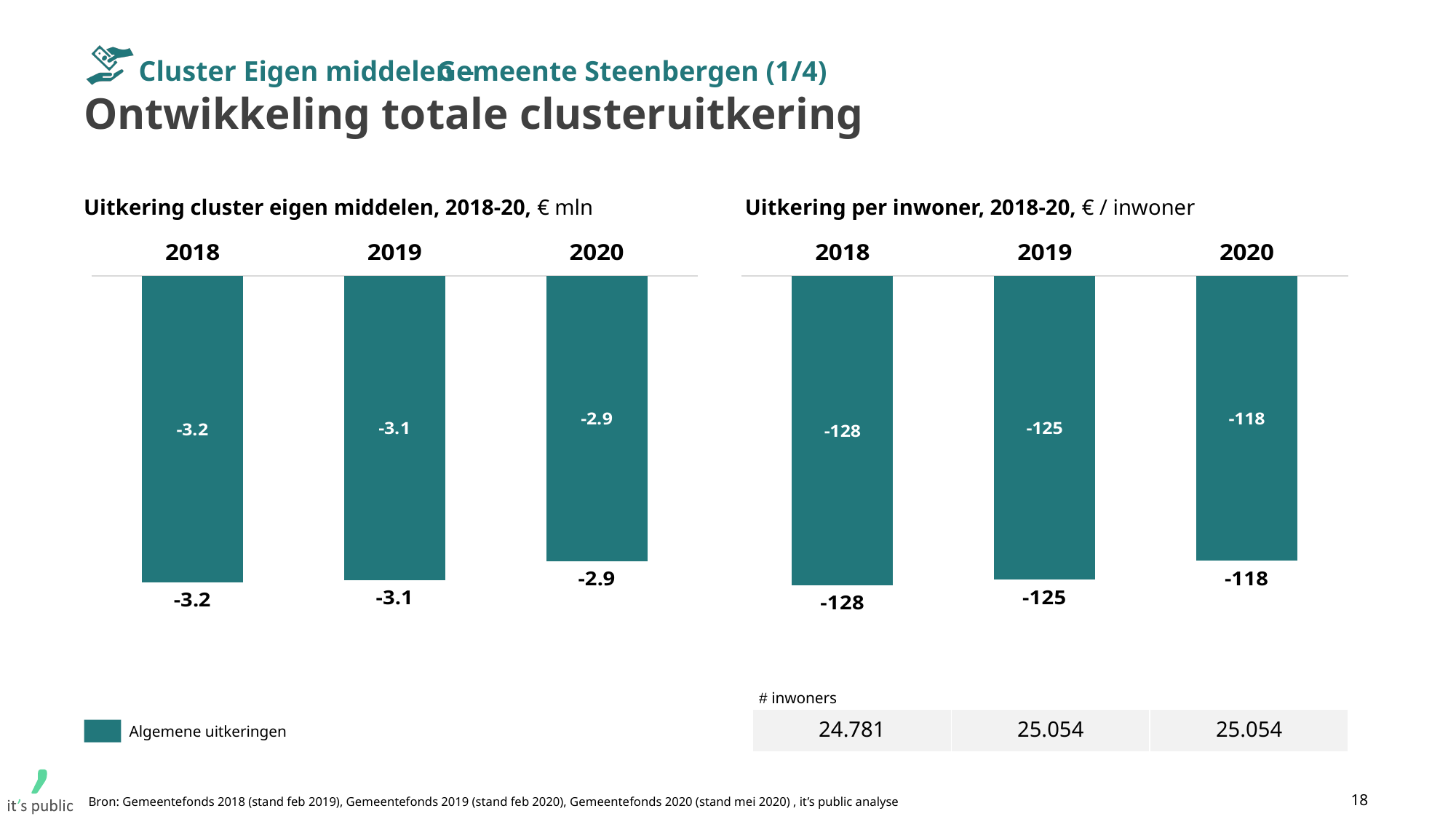
In the chart 'Uitkering cluster eigen middelen, 2018-20', what is the value for 2020? -2.9 In the chart 'Uitkering per inwoner, 2018-20', what is the value for 2020? -118 In the chart 'Uitkering cluster eigen middelen, 2018-20', what is the value for 2018? -3.2 In the chart 'Uitkering cluster eigen middelen, 2018-20', what is the difference between the 2019 value and the 2020 value? 0.2 What series name does the legend on the slide show? Algemene uitkeringen In the chart 'Uitkering per inwoner, 2018-20', is the value for 2018 or for 2019 more negative? 2018 What type of chart is 'Uitkering per inwoner, 2018-20'? Bar chart In the chart 'Uitkering cluster eigen middelen, 2018-20', which year has the lowest (most negative) value? 2018 How many years are shown in the chart 'Uitkering cluster eigen middelen, 2018-20'? 3 In the chart 'Uitkering per inwoner, 2018-20', what is the difference between the 2018 value and the 2020 value? 10 In the chart 'Uitkering per inwoner, 2018-20', which year has the highest (least negative) value? 2020 In the chart 'Uitkering per inwoner, 2018-20', what is the value for 2019? -125